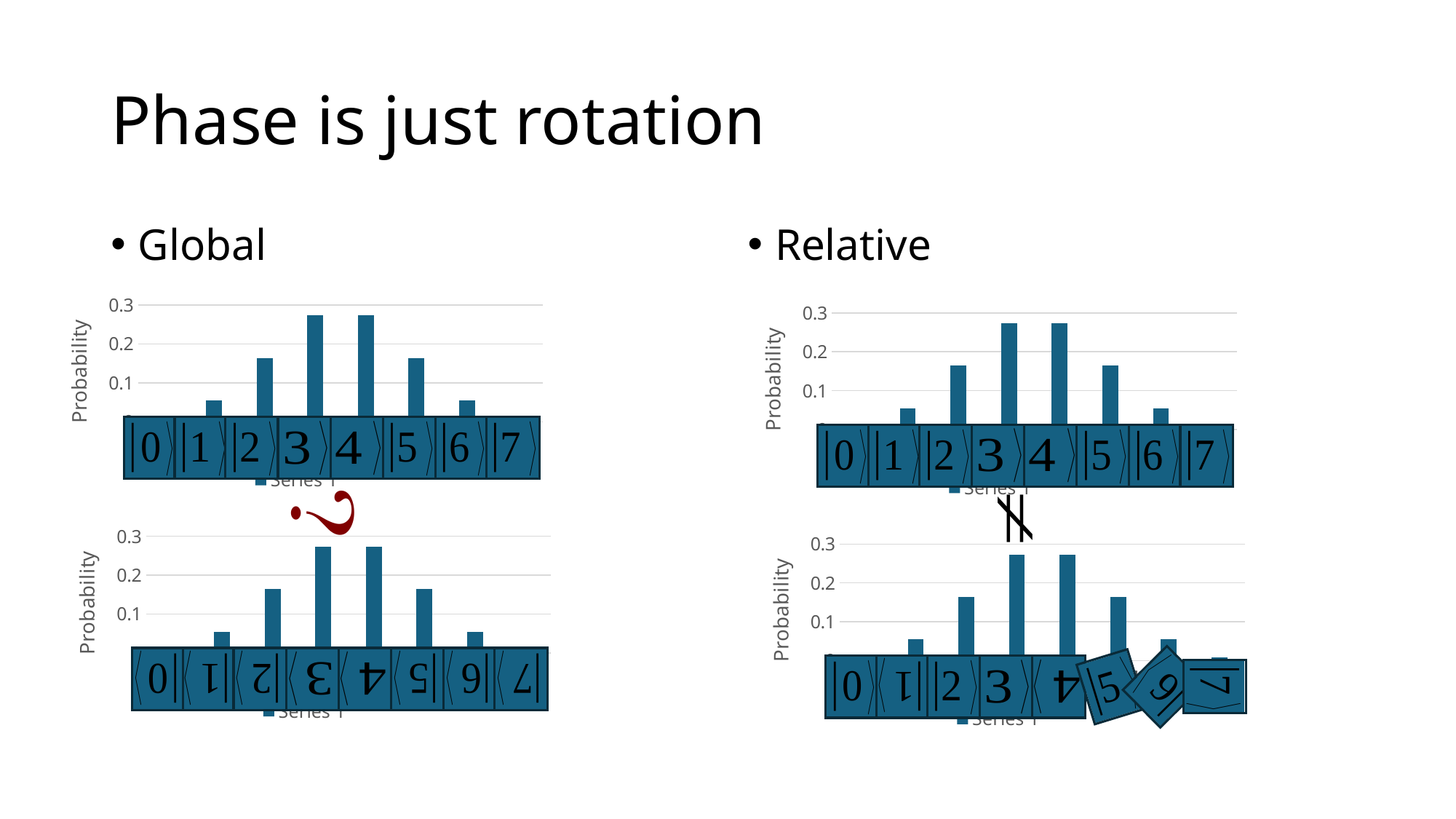
In the top chart under "Relative", is the value for the bar labelled 6 greater or less than 0.1? less In the top chart under "Global", which is larger, the bar labelled 2 or the bar labelled 1? 2 In the top chart under "Global", is the value for the bar labelled 3 greater or less than 0.2? greater In the bottom chart under "Global", is the value for the bar labelled 5 greater or less than 0.2? less In the bottom chart under "Relative", which is larger, the bar labelled 3 or the bar labelled 5? 3 How many bar charts are shown on the slide? 4 What kind of chart is the top chart under "Global"? bar chart What is the y-axis label of the top chart under "Global"? Probability